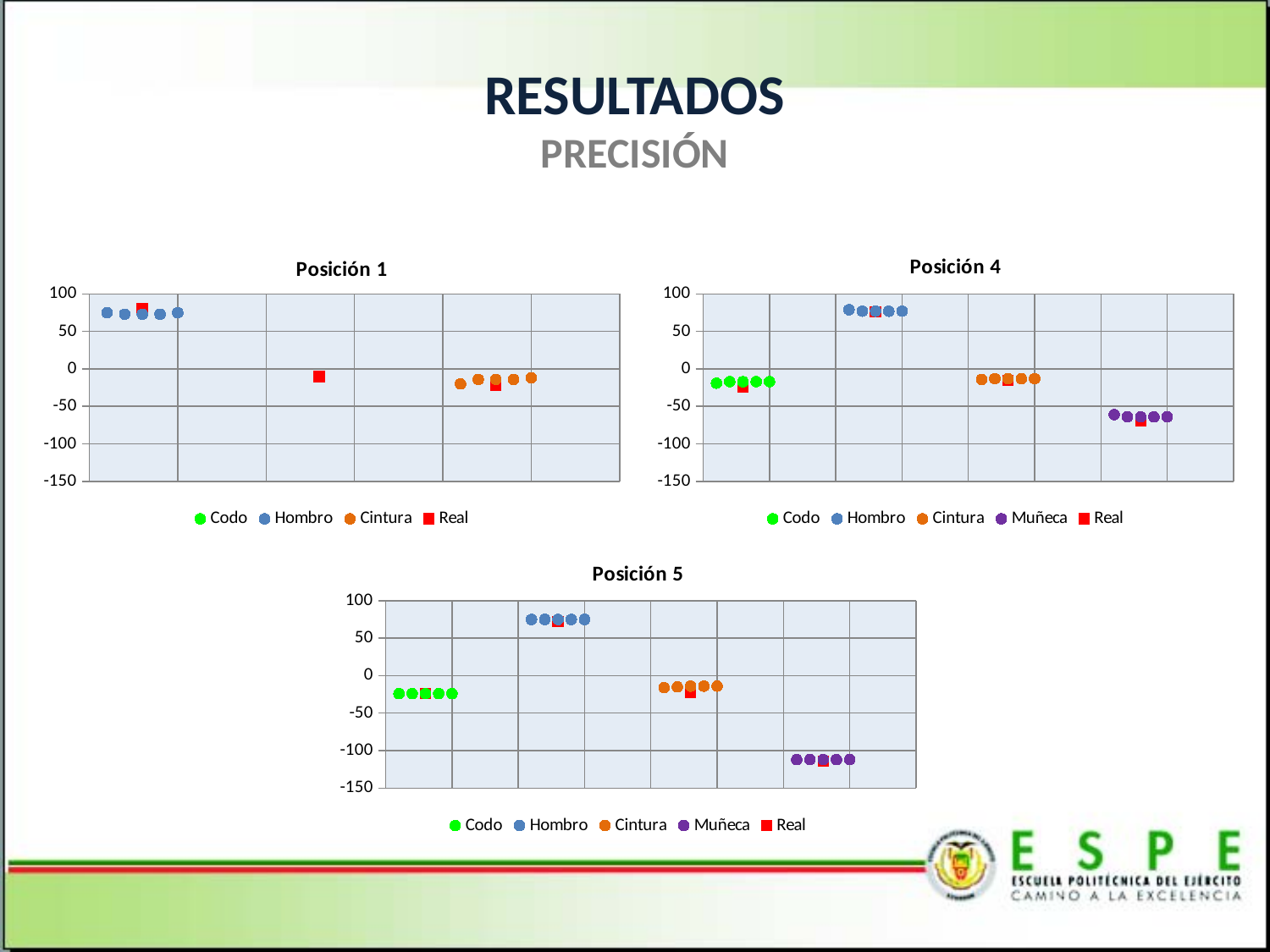
In the "Posición 5" chart, which series has the highest values, Hombro or Muñeca? Hombro How many series does the legend of the "Posición 1" chart list? 4 In the "Posición 1" chart, are the Cintura values greater or less than 0? less How many series does the legend of the "Posición 5" chart list? 5 In the "Posición 4" chart, are the Muñeca values greater or less than -50? less Which series appears in the legends of the "Posición 4" and "Posición 5" charts but not in the "Posición 1" chart? Muñeca How many series does the legend of the "Posición 4" chart list? 5 In the "Posición 5" chart, are the Muñeca values greater or less than -100? less In the "Posición 5" chart, which series has the lowest values? Muñeca What kind of chart is the "Posición 1" chart? scatter chart